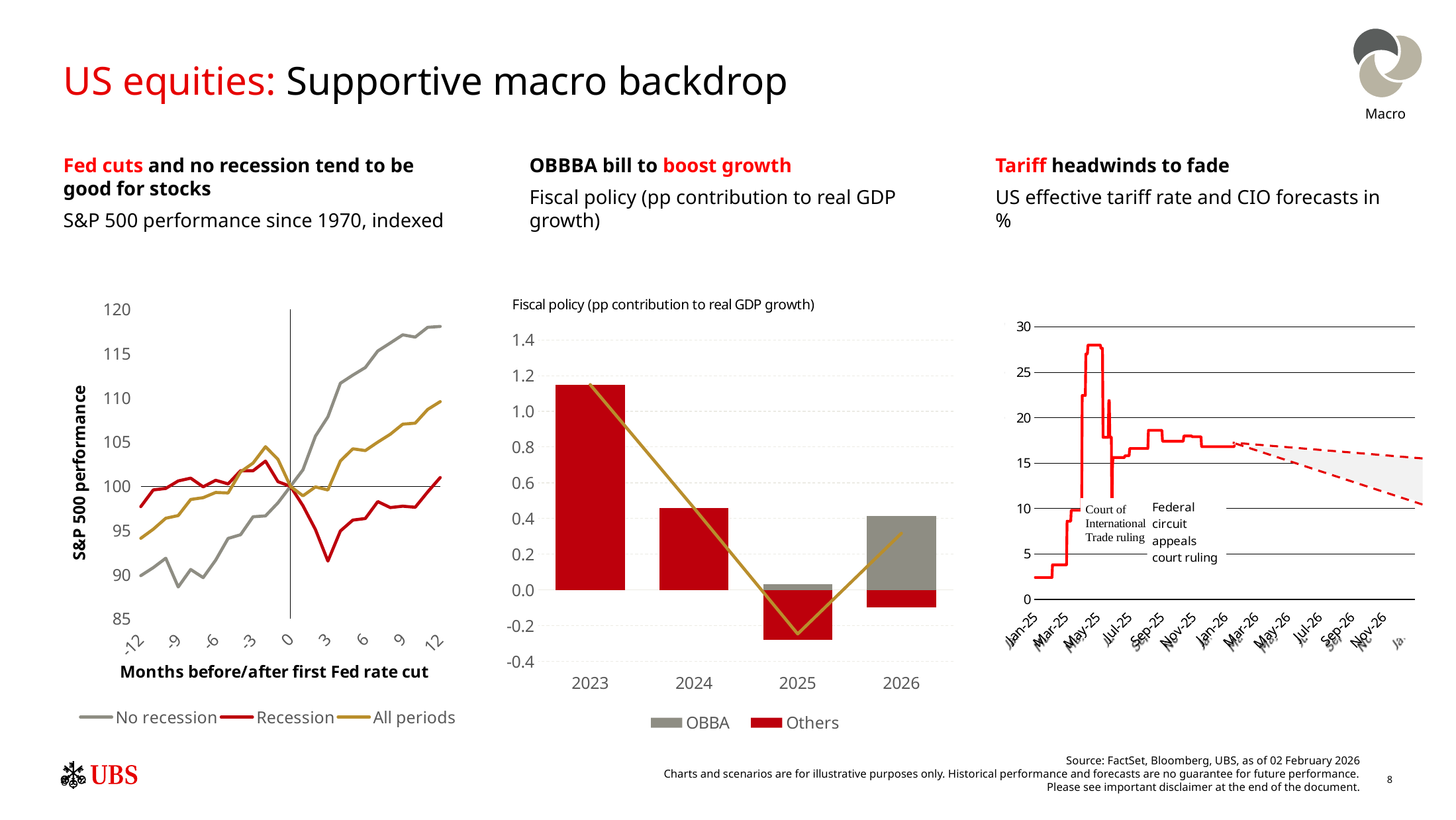
On the middle chart (Fiscal policy, pp contribution to real GDP growth), is the Others value for 2023 greater or less than 1.0? greater On the right chart (US effective tariff rate and CIO forecasts in %), is the value at Jan-25 greater or less than 5? less On the middle chart (Fiscal policy, pp contribution to real GDP growth), which year has the tallest Others bar? 2023 On the middle chart (Fiscal policy, pp contribution to real GDP growth), how many series does the legend list? 2 On the left chart (S&P 500 performance since 1970, indexed), is the Recession value at month 3 greater or less than 95? less On the left chart (S&P 500 performance since 1970, indexed), what kind of chart is it? line chart On the middle chart (Fiscal policy, pp contribution to real GDP growth), how many years are shown on the x axis? 4 On the left chart (S&P 500 performance since 1970, indexed), which series is highest at month 12? No recession On the left chart (S&P 500 performance since 1970, indexed), how many series does the legend list? 3 On the left chart (S&P 500 performance since 1970, indexed), does the No recession line rise or fall between month 0 and month 12? rise